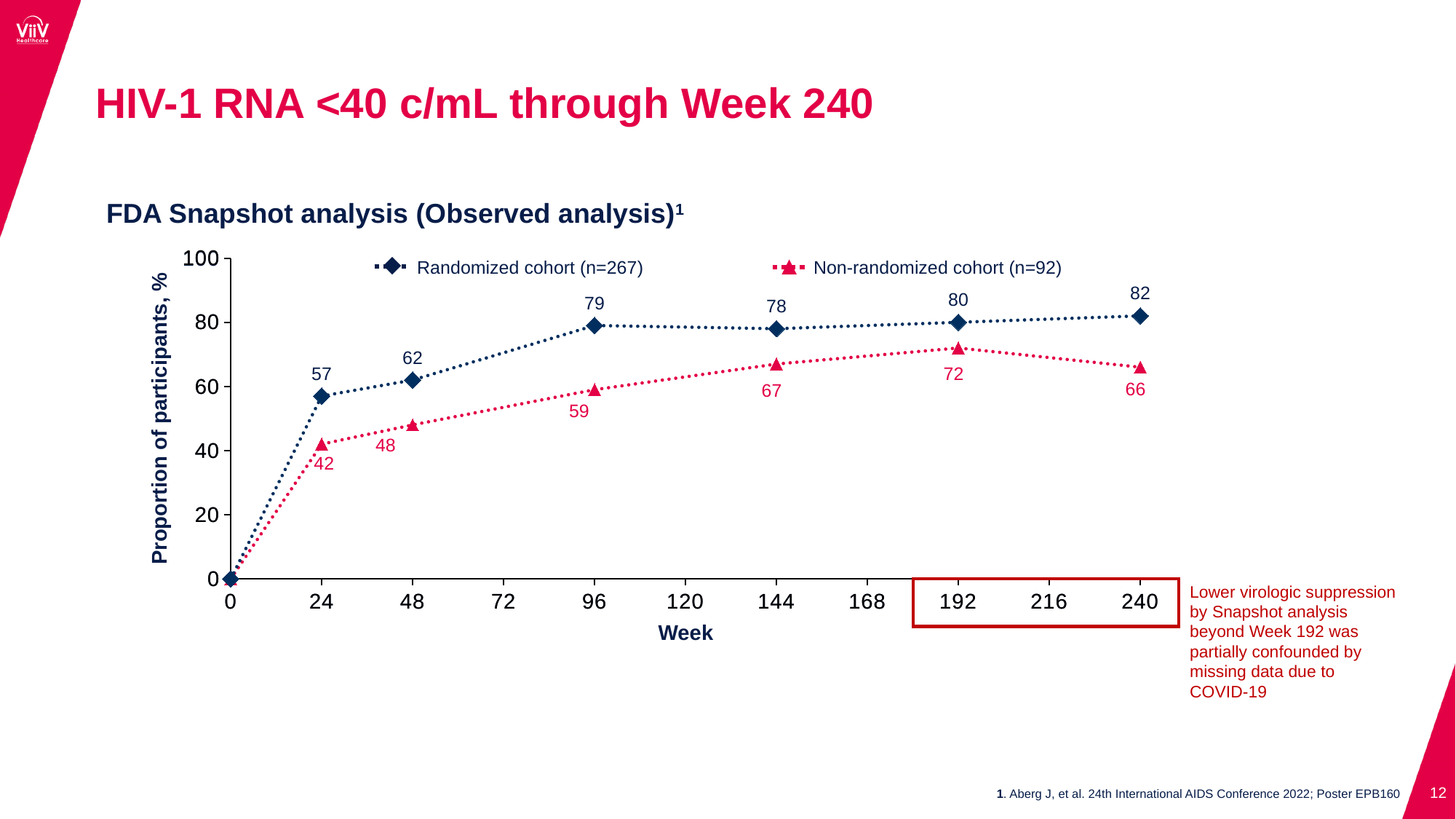
What is the value for the Randomized cohort at Week 240? 82 At which week (excluding Week 0) is the Randomized cohort value lowest? 24 At which week does the Non-randomized cohort reach its highest value? 192 How many series does the legend list? 2 What kind of chart is shown on the slide? Line chart What is the label of the y axis? Proportion of participants, % Is the Non-randomized cohort value at Week 96 greater or less than 60? less What is the value for the Randomized cohort at Week 96? 79 Which cohort has the higher value at Week 48? Randomized cohort What is the value for the Non-randomized cohort at Week 144? 67 Does the Non-randomized cohort value rise or fall between Week 192 and Week 240? Fall What is the difference between the Randomized and Non-randomized cohort values at Week 240? 16